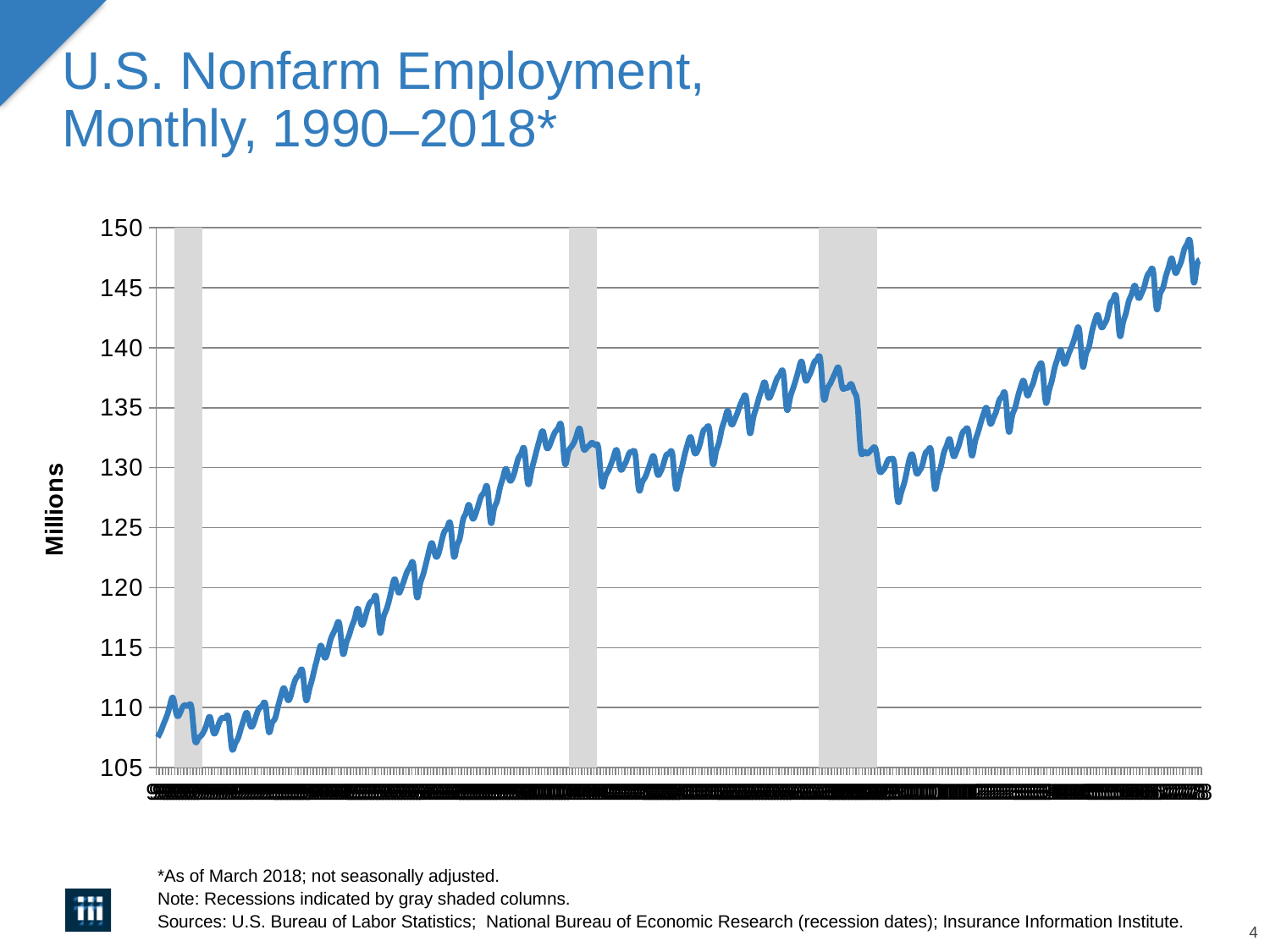
Is the lowest point on the line greater or less than 105? greater Overall, do the values rise or fall from the left to the right of the chart? rise What is the label on the vertical axis of the chart? Millions Is the value at the end of the series greater or less than the value at the start of the series? greater Is the value at the end of the series (far right) greater or less than 145? greater What kind of chart is shown on the slide? line chart How many gray shaded recession columns are shown on the chart? 3 Is the highest point on the line greater or less than 150? less What is the highest value shown on the vertical axis? 150 What is the title of the chart? U.S. Nonfarm Employment, Monthly, 1990–2018*